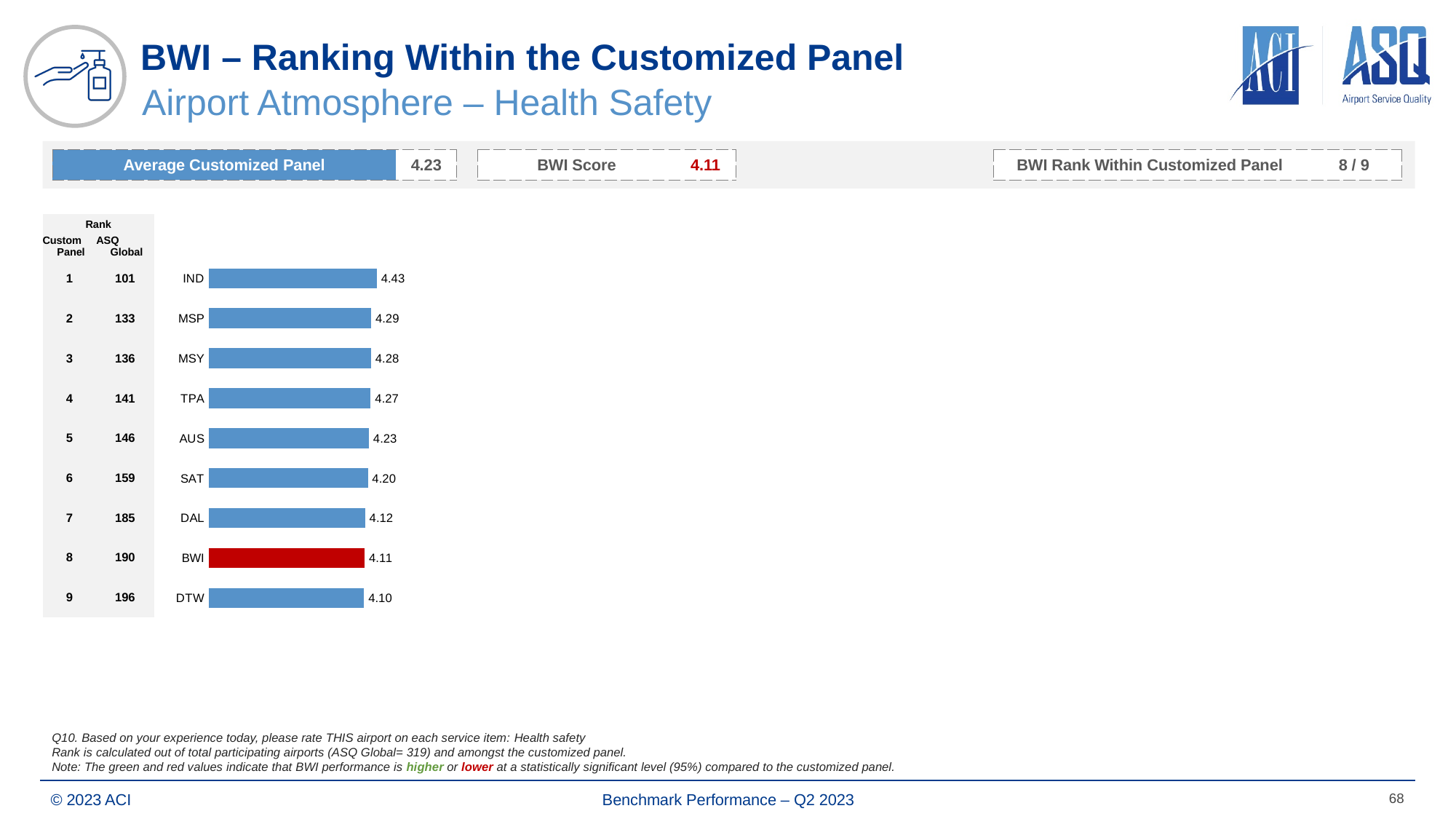
Which airport has the highest value? IND What is the value for SAT? 4.20 Which airport has the lowest value? DTW What is the value for BWI? 4.11 What is the difference between the values for MSP and DTW? 0.19 What is the value for IND? 4.43 What is the difference between the values for IND and BWI? 0.32 How many airports are shown in the chart? 9 What kind of chart is shown on the slide? Bar chart Which has a larger value, TPA or DAL? TPA Which bar is coloured red? BWI What is the ASQ Global rank shown for BWI? 190